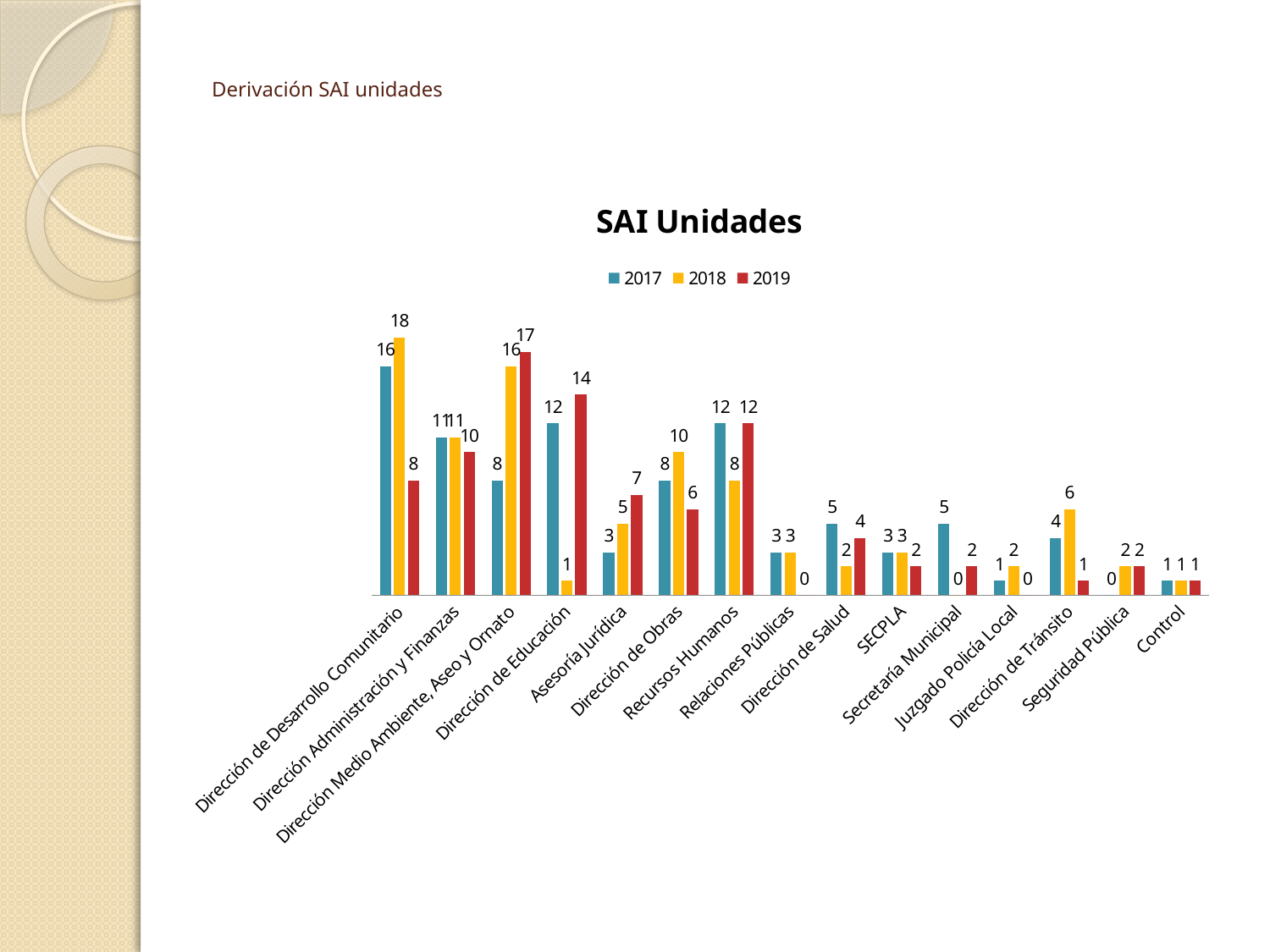
What is the difference between the 2018 and 2019 values for Dirección de Desarrollo Comunitario? 10 What is the 2018 value for Dirección de Desarrollo Comunitario? 18 What is the 2017 value for Secretaría Municipal? 5 Which category has the highest 2019 value? Dirección Medio Ambiente, Aseo y Ornato What is the title of the chart? SAI Unidades How many series does the legend list? 3 What is the total of the three values for Asesoría Jurídica? 15 What is the 2019 value for Dirección de Educación? 14 Which category has the lowest 2017 value? Seguridad Pública How many categories are shown on the x axis? 15 Which is larger for Dirección de Obras, the 2018 value or the 2019 value? 2018 What kind of chart is this? Bar chart